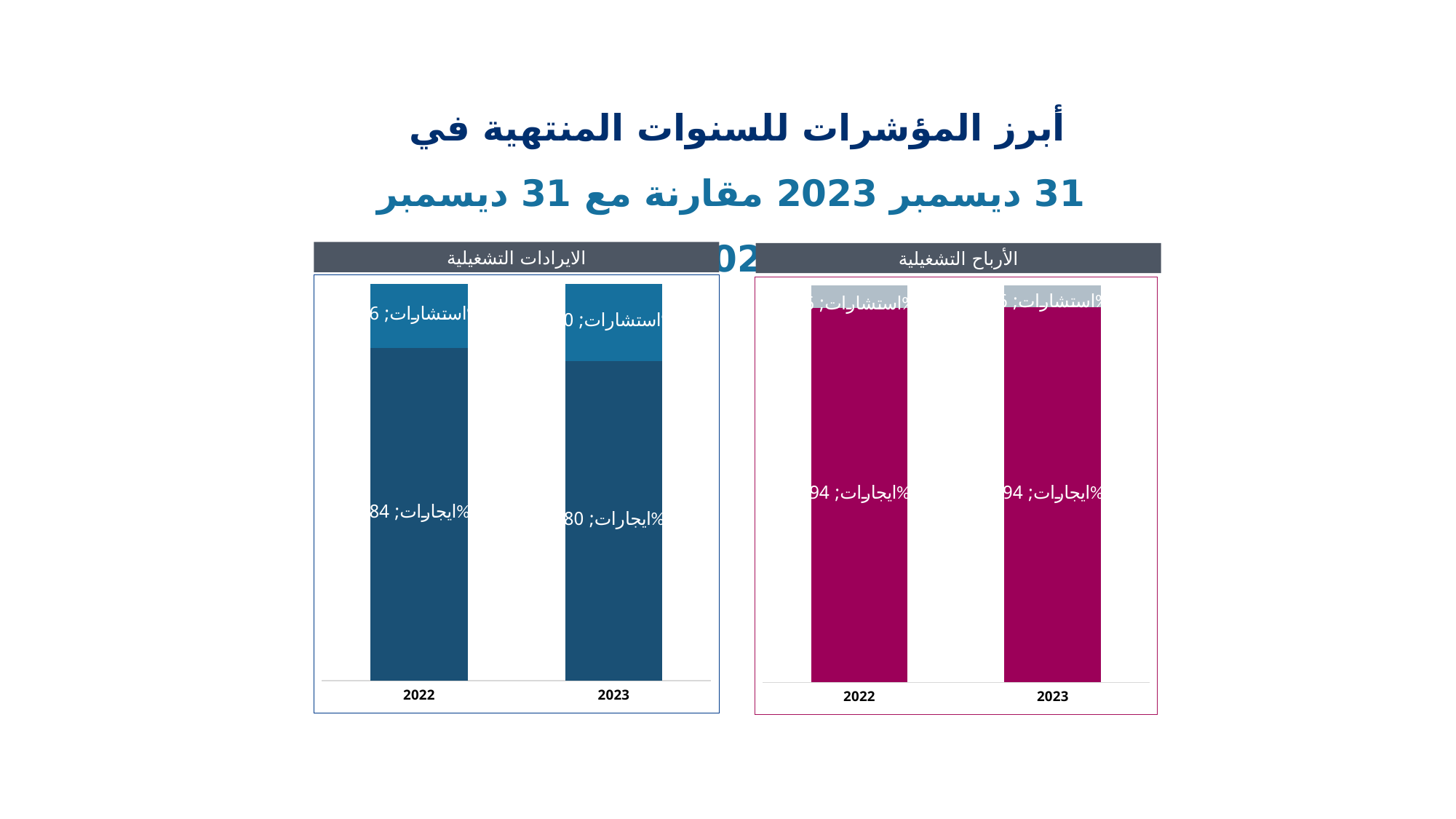
In the left chart (الايرادات التشغيلية), what is the value labelled for ايجارات in 2023? 80% How many segments make up each stacked bar in the left chart (الايرادات التشغيلية)? 2 In the left chart (الايرادات التشغيلية), what is the value labelled for ايجارات in 2022? 84% How many years are shown on the x axis of the right chart (الأرباح التشغيلية)? 2 What kind of chart is the left chart (الايرادات التشغيلية)? stacked bar chart In the left chart (الايرادات التشغيلية), by how many percentage points does the ايجارات share differ between 2022 and 2023? 4 percentage points What is the title of the right chart on the slide? الأرباح التشغيلية In the left chart (الايرادات التشغيلية), which year has the larger ايجارات share, 2022 or 2023? 2022 In the right chart (الأرباح التشغيلية), what is the value labelled for ايجارات in 2023? 94% In the right chart (الأرباح التشغيلية), what is the value labelled for ايجارات in 2022? 94% In the left chart (الايرادات التشغيلية), does the ايجارات share rise or fall from 2022 to 2023? fall In the right chart (الأرباح التشغيلية), is the ايجارات share in 2023 larger, smaller, or the same as in 2022? the same